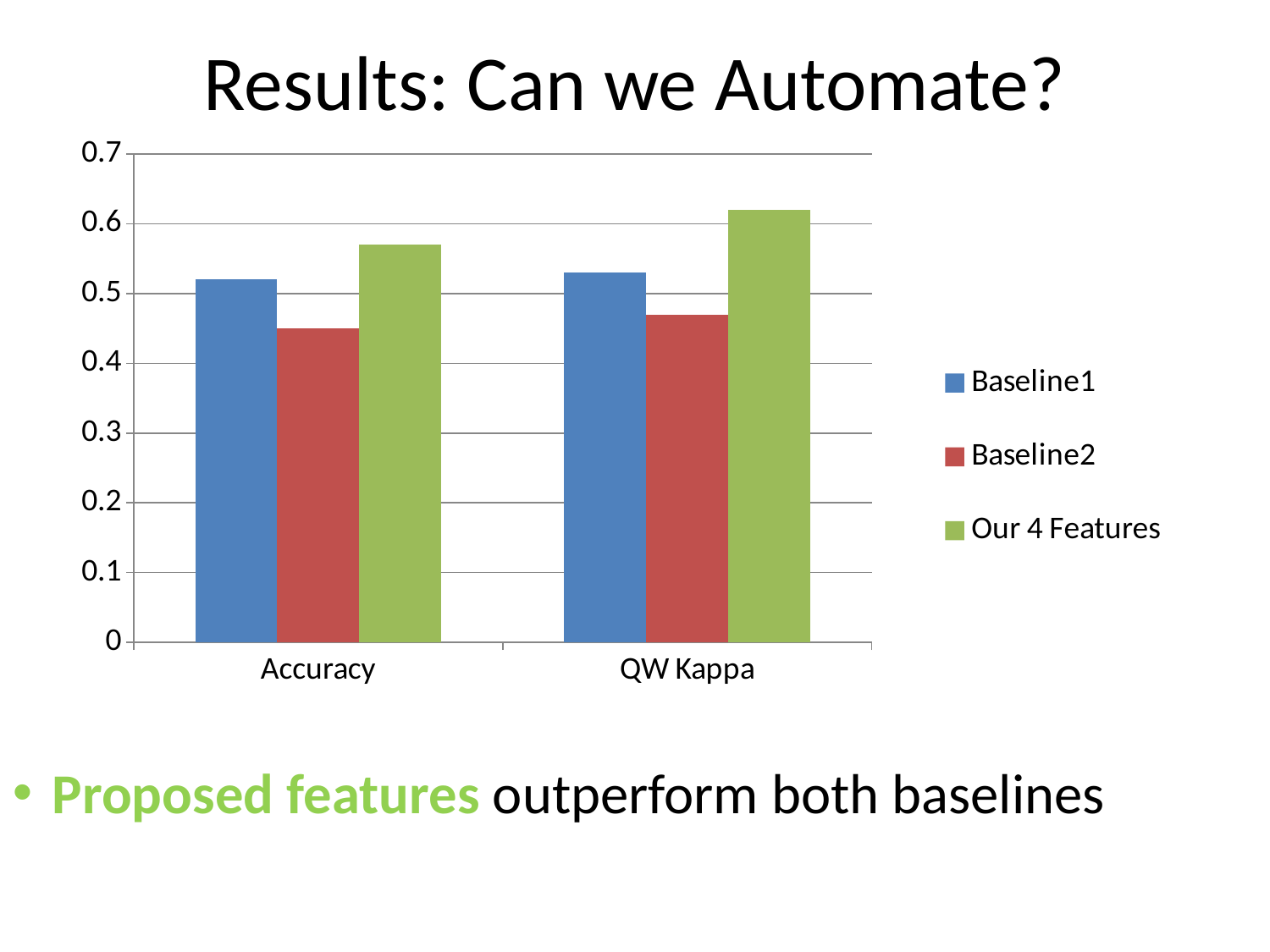
How many categories are shown on the x axis? 2 For Accuracy, which is larger: Baseline1 or Our 4 Features? Our 4 Features Is the value for Baseline2 in QW Kappa greater or less than 0.5? less Is the value for Our 4 Features in Accuracy greater or less than 0.6? less Which series has the lowest value for Accuracy? Baseline2 Is the value for Baseline2 in Accuracy greater or less than 0.5? less What kind of chart is shown on the slide? bar chart Which series has the highest value for QW Kappa? Our 4 Features For QW Kappa, which is larger: Baseline1 or Baseline2? Baseline1 How many series does the legend list? 3 What colour are the bars for the Our 4 Features series? green